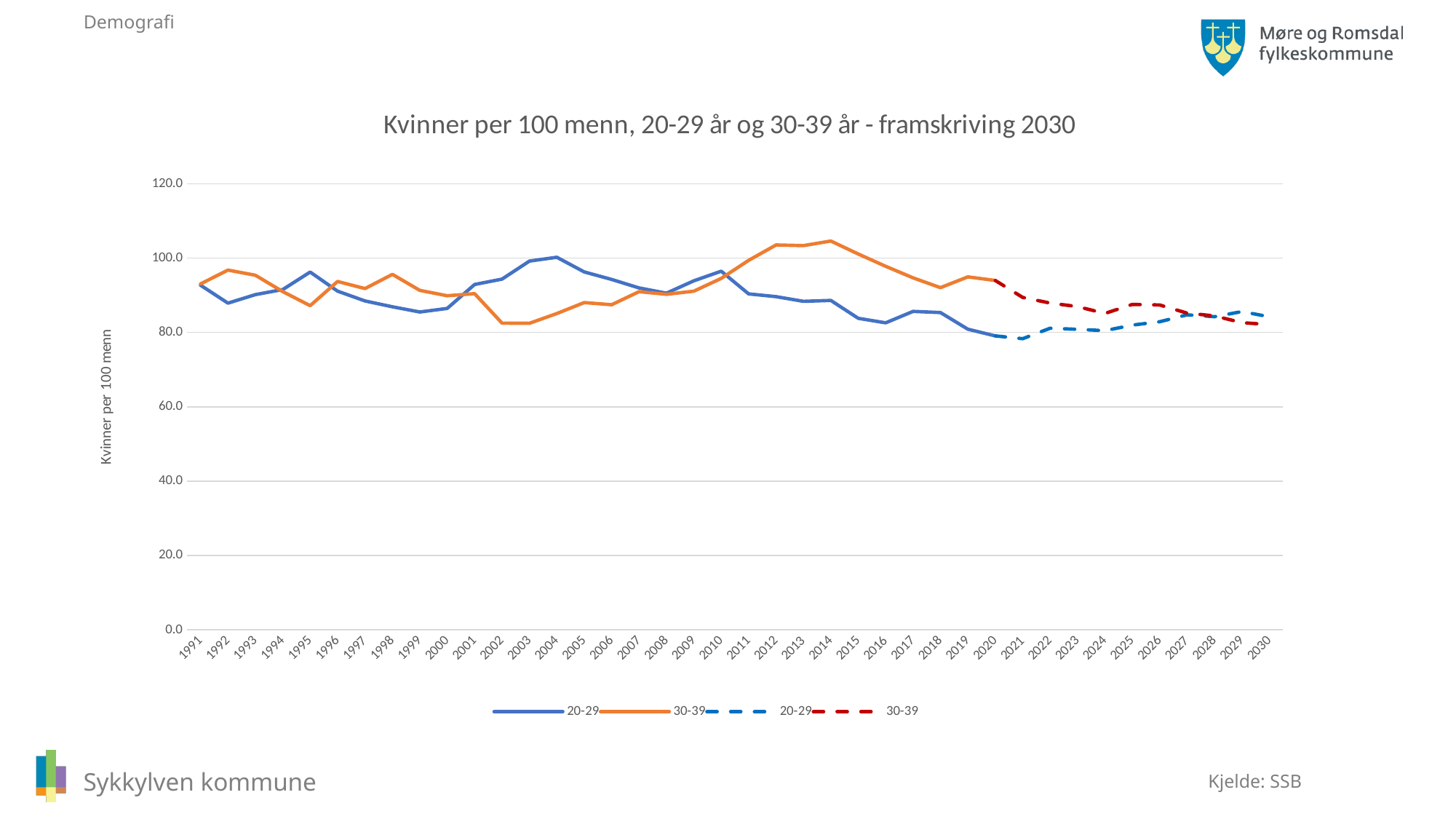
Is the value for the 20-29 series in 1999 greater or less than 100? less How many entries does the chart legend list? 4 Does the 20-29 series rise or fall between 2014 and 2020? fall What kind of chart is shown on the slide? line chart In 2004, which series has the higher value, 20-29 or 30-39? 20-29 Is the value for the 30-39 series in 2012 greater or less than 100? greater In 2014, which series has the higher value, 20-29 or 30-39? 30-39 What is the title of the chart? Kvinner per 100 menn, 20-29 år og 30-39 år - framskriving 2030 Is the value for the 30-39 series in 2014 greater or less than 100? greater How many years are shown along the x axis of the chart? 40 What is the label on the vertical axis of the chart? Kvinner per 100 menn